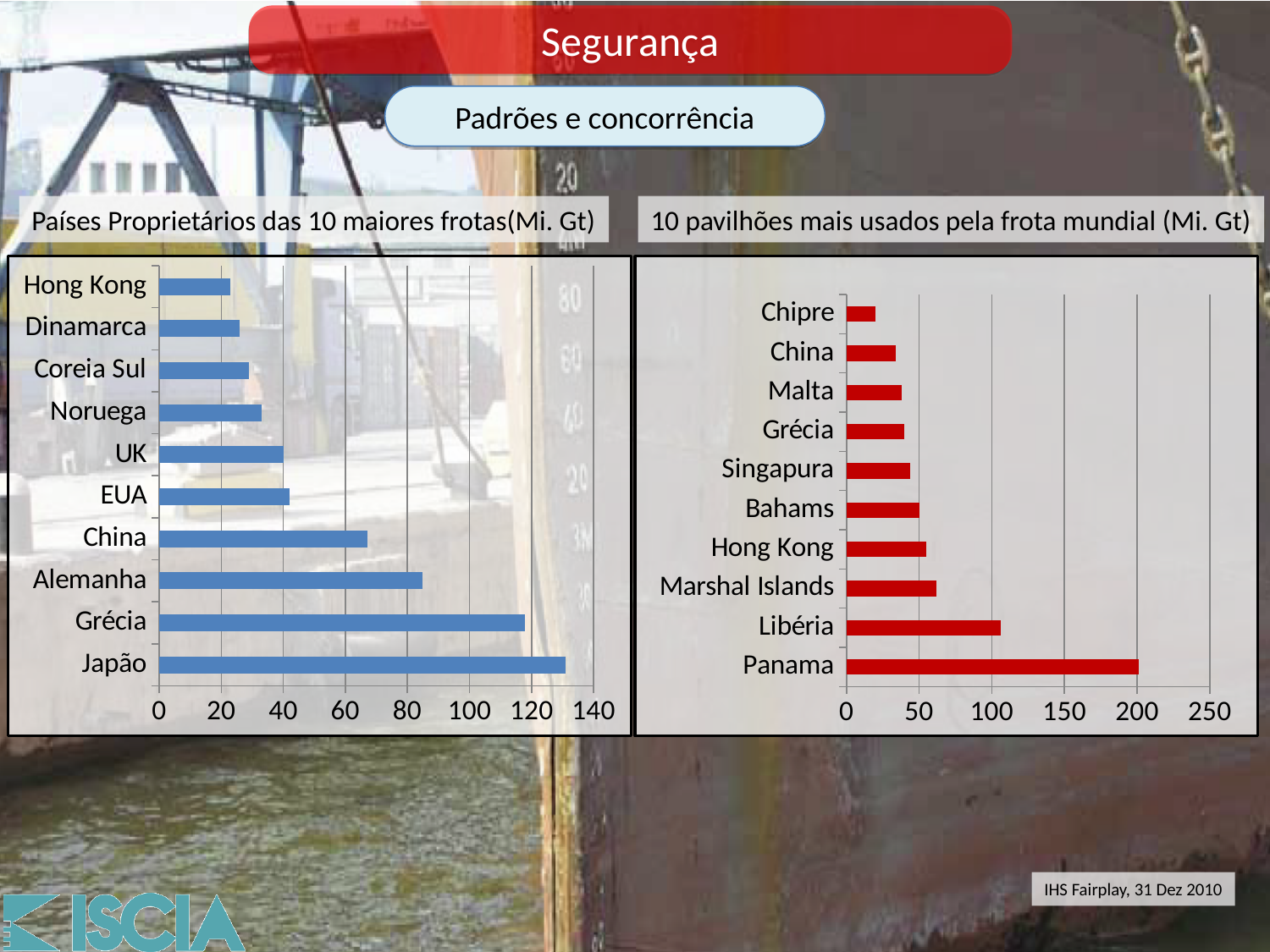
In the right chart, '10 pavilhões mais usados pela frota mundial', is the value for Malta greater or less than 50? less How many flags are shown in the right chart, '10 pavilhões mais usados pela frota mundial'? 10 How many countries are shown in the left chart, 'Países Proprietários das 10 maiores frotas'? 10 In the left chart, 'Países Proprietários das 10 maiores frotas', is the value for China greater or less than 60? greater In the left chart, 'Países Proprietários das 10 maiores frotas', which country has the highest value? Japão What colour are the bars in the right chart, '10 pavilhões mais usados pela frota mundial'? red In the right chart, '10 pavilhões mais usados pela frota mundial', which flag has the lowest value? Chipre What kind of chart is the 'Países Proprietários das 10 maiores frotas' chart on the left? bar chart In the left chart, 'Países Proprietários das 10 maiores frotas', which has the larger value, Alemanha or Grécia? Grécia In the right chart, '10 pavilhões mais usados pela frota mundial', which flag has the highest value? Panama In the left chart, 'Países Proprietários das 10 maiores frotas', which country has the lowest value? Hong Kong In the left chart, 'Países Proprietários das 10 maiores frotas', is the value for Grécia greater or less than 100? greater